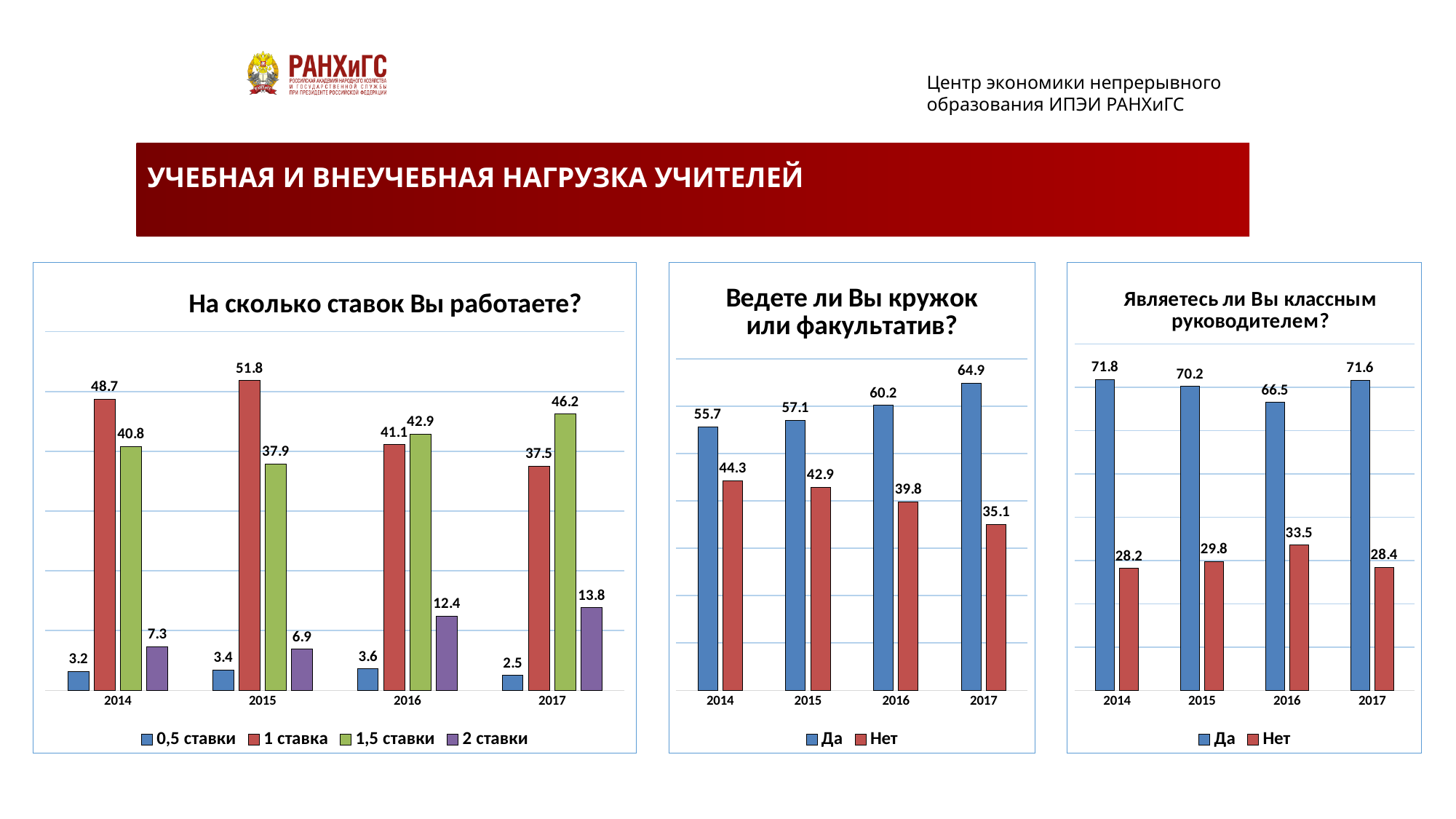
In the chart 'Ведете ли Вы кружок или факультатив?', which year has the highest value for 'Да'? 2017 What kind of chart is 'Являетесь ли Вы классным руководителем?'? bar chart In the chart 'На сколько ставок Вы работаете?', what is the difference between '1,5 ставки' and '1 ставка' in 2017? 8.7 In the chart 'На сколько ставок Вы работаете?', how many series does the legend list? 4 In the chart 'Являетесь ли Вы классным руководителем?', what is the value for 'Нет' in 2016? 33.5 In the chart 'На сколько ставок Вы работаете?', what is the value for '1 ставка' in 2015? 51.8 In the chart 'На сколько ставок Вы работаете?', which year has the lowest value for '0,5 ставки'? 2017 In the chart 'Являетесь ли Вы классным руководителем?', which year has the lowest value for 'Да'? 2016 In the chart 'На сколько ставок Вы работаете?', what is the value for '2 ставки' in 2017? 13.8 In the chart 'Ведете ли Вы кружок или факультатив?', do the 'Да' values rise or fall from 2014 to 2017? rise In the chart 'Являетесь ли Вы классным руководителем?', what is the difference between 'Да' and 'Нет' in 2014? 43.6 In the chart 'Ведете ли Вы кружок или факультатив?', what is the value for 'Да' in 2016? 60.2